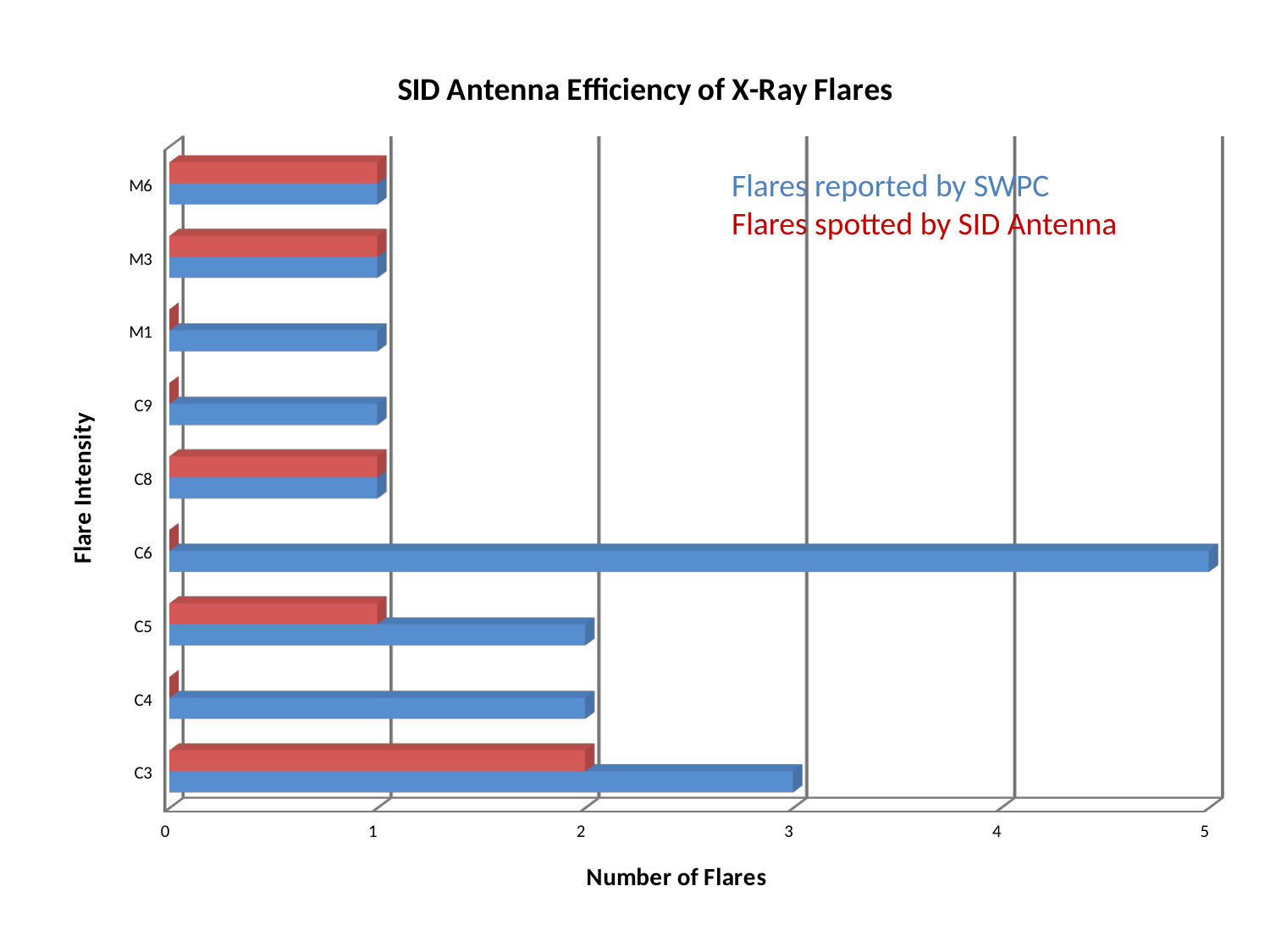
Which flare intensity has the highest number of flares spotted by SID Antenna? C3 What kind of chart is shown on the slide? bar chart How many flares spotted by SID Antenna are shown for C3? 2 How many flares reported by SWPC are shown for C6? 5 What is the title of the chart? SID Antenna Efficiency of X-Ray Flares Which flare intensity has the highest number of flares reported by SWPC? C6 How many flare intensity categories are shown on the chart? 9 How many series does the legend list? 2 Which is larger for C5: flares reported by SWPC or flares spotted by SID Antenna? Flares reported by SWPC Is the number of flares reported by SWPC for C6 greater or less than 4? greater How many flares reported by SWPC are shown for C3? 3 What is the difference between flares reported by SWPC and flares spotted by SID Antenna for C6? 5